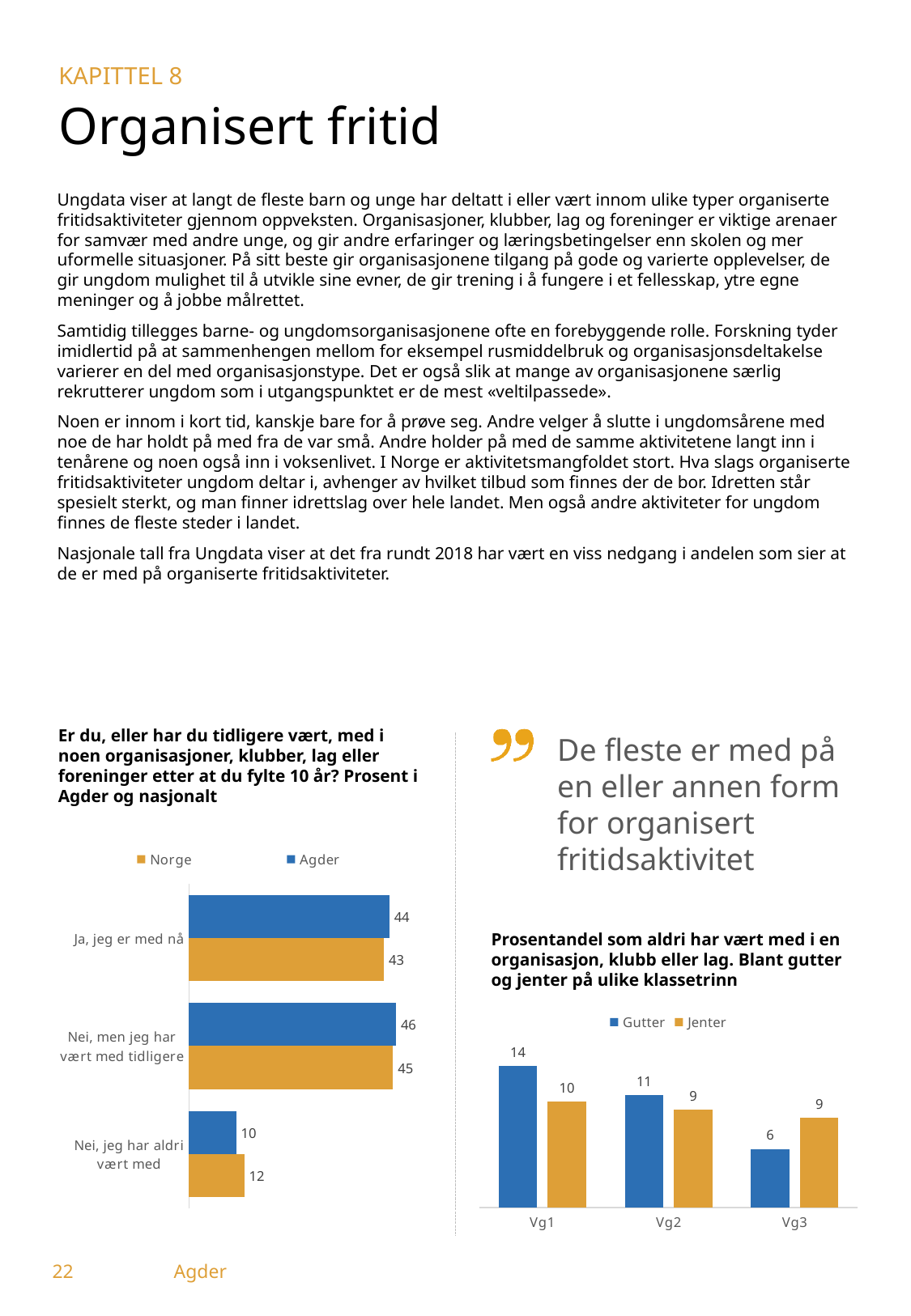
In the left chart (Er du, eller har du tidligere vært, med i noen organisasjoner...), what is the difference between Agder and Norge for 'Nei, jeg har aldri vært med'? 2 In the right chart (Prosentandel som aldri har vært med i en organisasjon...), what is the value for Gutter at Vg1? 14 In the right chart (Prosentandel som aldri har vært med i en organisasjon...), what is the difference between Gutter and Jenter at Vg1? 4 In the left chart (Er du, eller har du tidligere vært, med i noen organisasjoner...), what is the value for Agder for 'Ja, jeg er med nå'? 44 In the left chart (Er du, eller har du tidligere vært, med i noen organisasjoner...), how many series does the legend list? 2 In the right chart (Prosentandel som aldri har vært med i en organisasjon...), which is larger at Vg3, Gutter or Jenter? Jenter In the left chart (Er du, eller har du tidligere vært, med i noen organisasjoner...), what kind of chart is it? Bar chart In the right chart (Prosentandel som aldri har vært med i en organisasjon...), what is the value for Jenter at Vg3? 9 In the right chart (Prosentandel som aldri har vært med i en organisasjon...), do the Gutter values rise or fall from Vg1 to Vg3? Fall In the left chart (Er du, eller har du tidligere vært, med i noen organisasjoner...), what is the value for Norge for 'Nei, jeg har aldri vært med'? 12 In the left chart (Er du, eller har du tidligere vært, med i noen organisasjoner...), which category has the lowest value for Agder? Nei, jeg har aldri vært med In the right chart (Prosentandel som aldri har vært med i en organisasjon...), how many class levels are shown on the x axis? 3